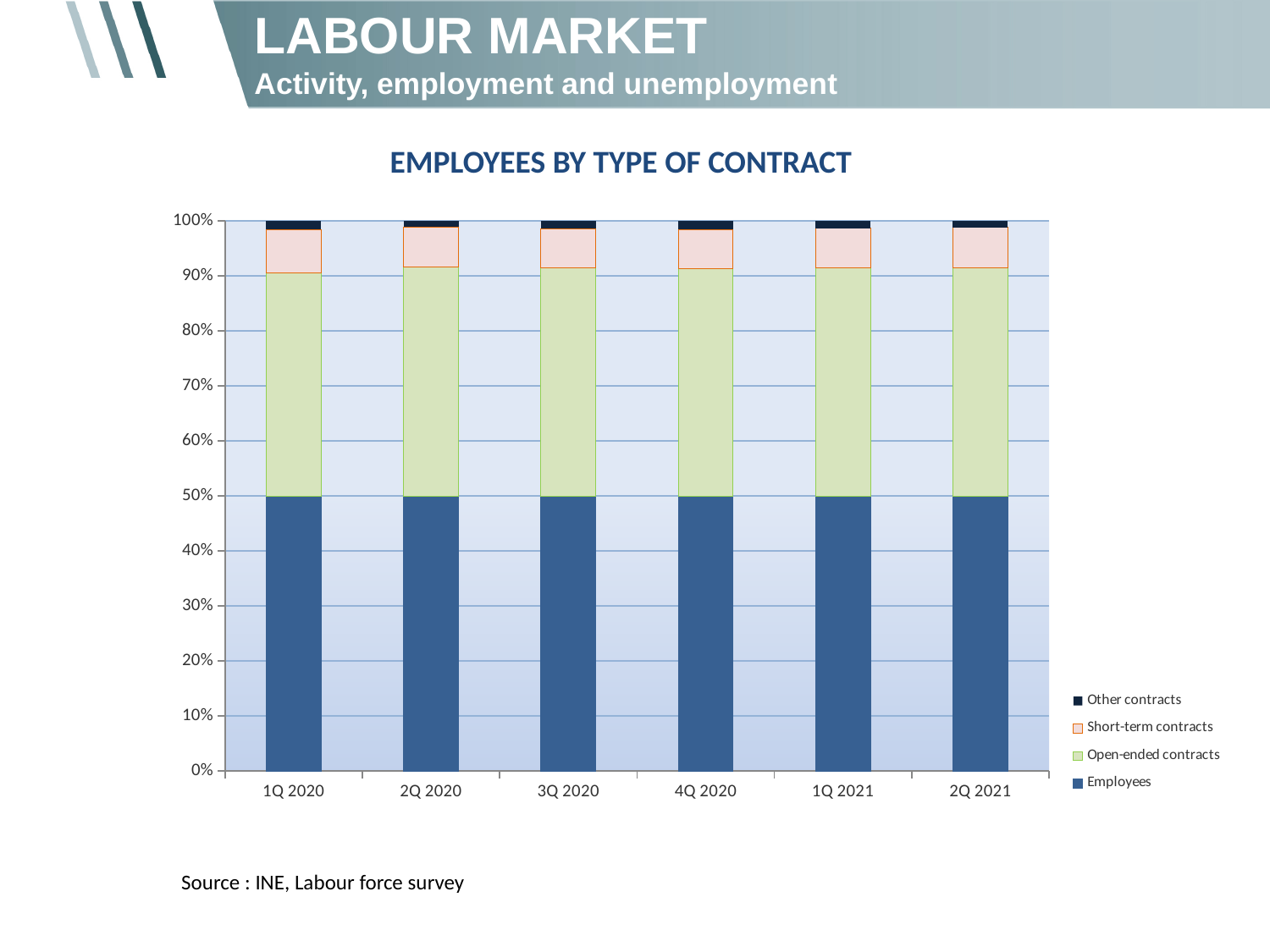
Is the Short-term contracts share in 2Q 2021 greater or less than 20%? less Is the Open-ended contracts share in 3Q 2020 greater or less than 30%? greater Which series has the smallest segment in 1Q 2021? Other contracts Is the Other contracts share in 4Q 2020 greater or less than 10%? less How many series does the legend list? 4 Which series is shown at the bottom of each stacked bar? Employees How many quarters are shown on the x axis? 6 What kind of chart is shown on the slide? Stacked bar chart What is the title of the chart? EMPLOYEES BY TYPE OF CONTRACT What is the total height of the stacked bar for 1Q 2021? 100% In 2Q 2020, which segment is larger: Open-ended contracts or Short-term contracts? Open-ended contracts